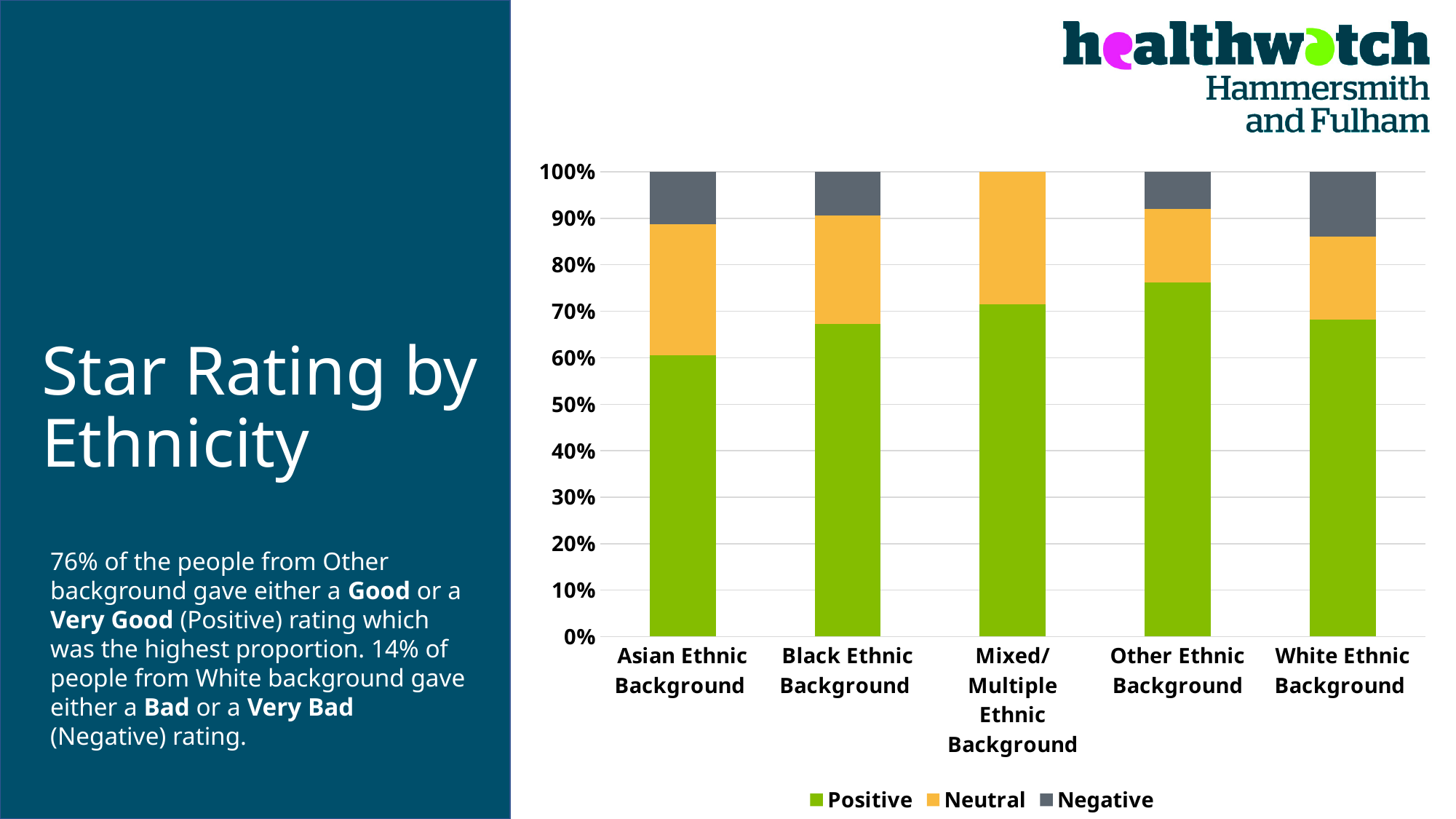
Which colour represents the Positive series in the legend? green Which ethnic background has the lowest Positive share? Asian Ethnic Background According to the slide, what percentage of people from Other background gave a Positive rating? 76% Is the Positive value for Other Ethnic Background greater or less than 70%? greater Which ethnic background has the largest Negative share? White Ethnic Background Which has the larger Positive share, Asian Ethnic Background or Black Ethnic Background? Black Ethnic Background Which ethnic background has the highest Positive share? Other Ethnic Background How many series does the legend list? 3 What kind of chart is shown on the slide? bar chart Which ethnic background shows no Negative segment at all? Mixed/Multiple Ethnic Background How many ethnic background categories are shown on the x axis? 5 Is the Positive value for Asian Ethnic Background greater or less than 70%? less